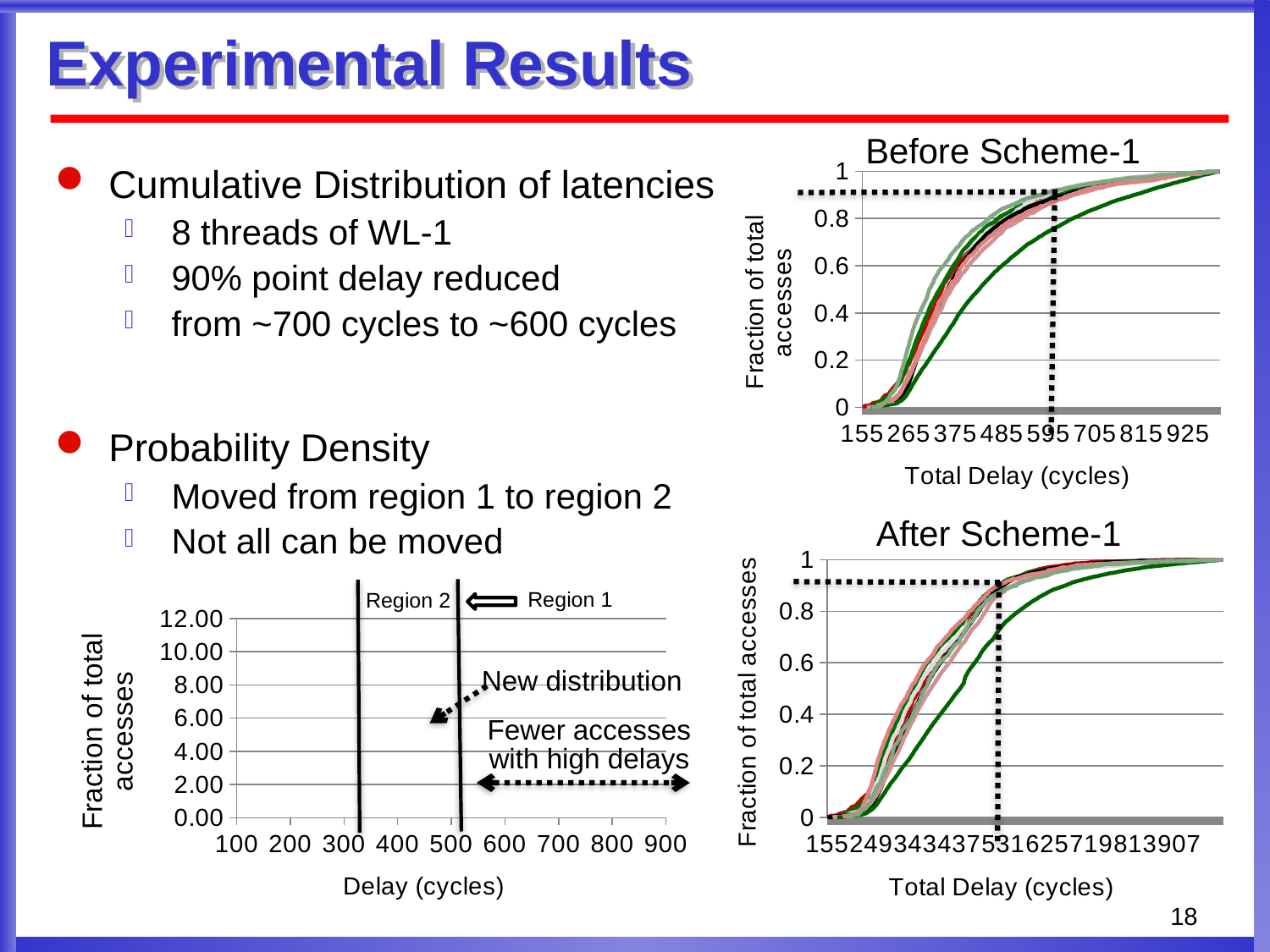
In the "After Scheme-1" chart, do the lines rise or fall as Total Delay increases along the x axis? rise What kind of chart is the "After Scheme-1" chart? line chart How many tick labels are shown on the x axis of the "After Scheme-1" chart? 9 What is the highest tick label on the y axis of the bottom-left chart? 12.00 What is the x-axis title of the "Before Scheme-1" chart? Total Delay (cycles) How many tick labels are shown on the x axis of the "Before Scheme-1" chart? 8 What kind of chart is the "Before Scheme-1" chart? line chart In the "After Scheme-1" chart, is the value of the dark green line at a Total Delay of 531 cycles greater or less than 0.6? greater In the "Before Scheme-1" chart, do the lines rise or fall as Total Delay increases along the x axis? rise